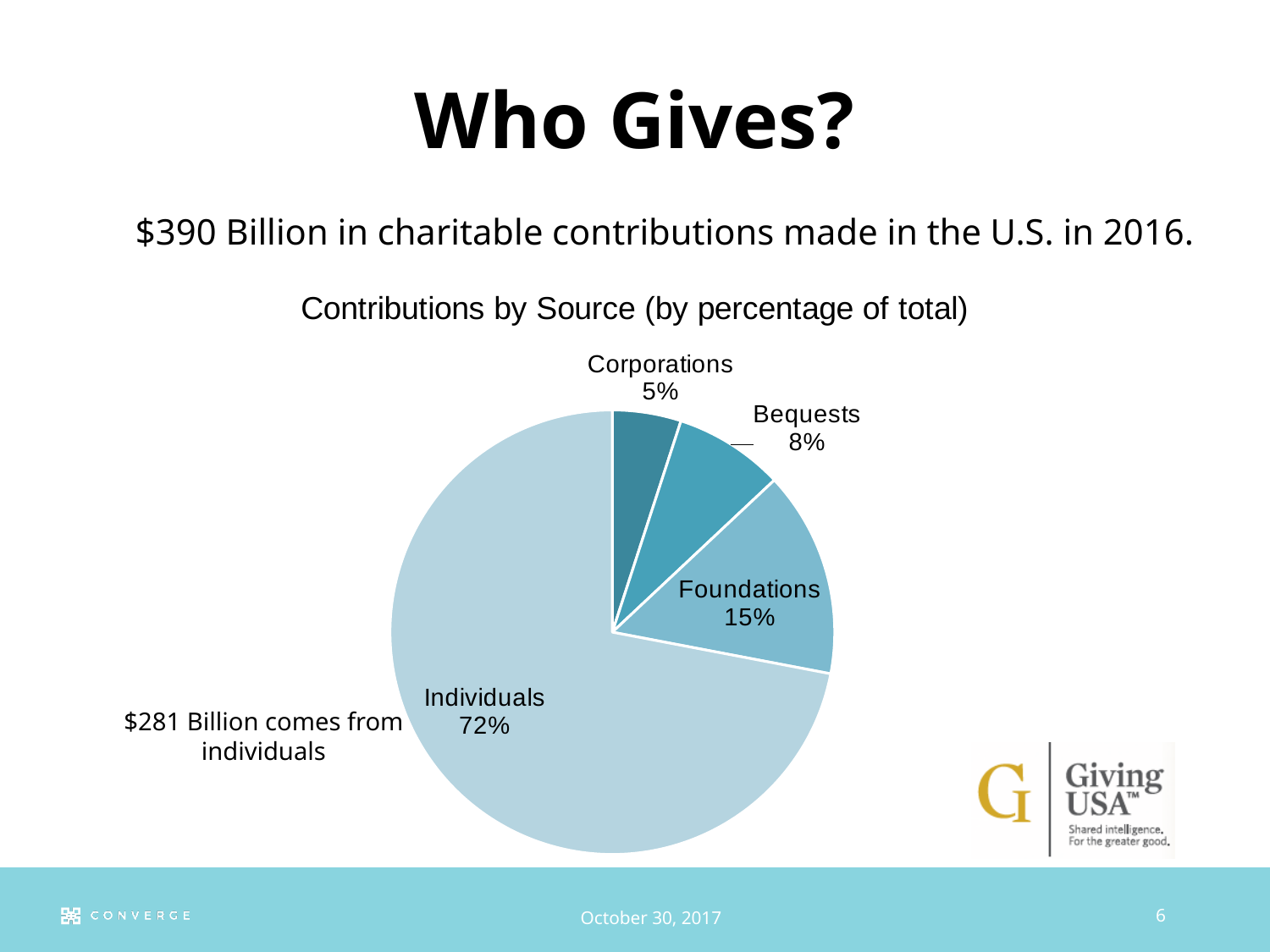
What is the title of the chart? Contributions by Source (by percentage of total) What is the difference in percentage points between Foundations and Bequests? 7 What kind of chart is shown on the slide? pie chart What percentage of contributions comes from Bequests? 8% What percentage of contributions comes from Individuals? 72% What is the difference in percentage points between Individuals and Foundations? 57 Which source has the largest share of contributions? Individuals Which is larger, the share for Bequests or the share for Corporations? Bequests Which source has the smallest share of contributions? Corporations How many slices does the pie chart have? 4 What percentage of contributions comes from Foundations? 15% What percentage of contributions comes from Corporations? 5%